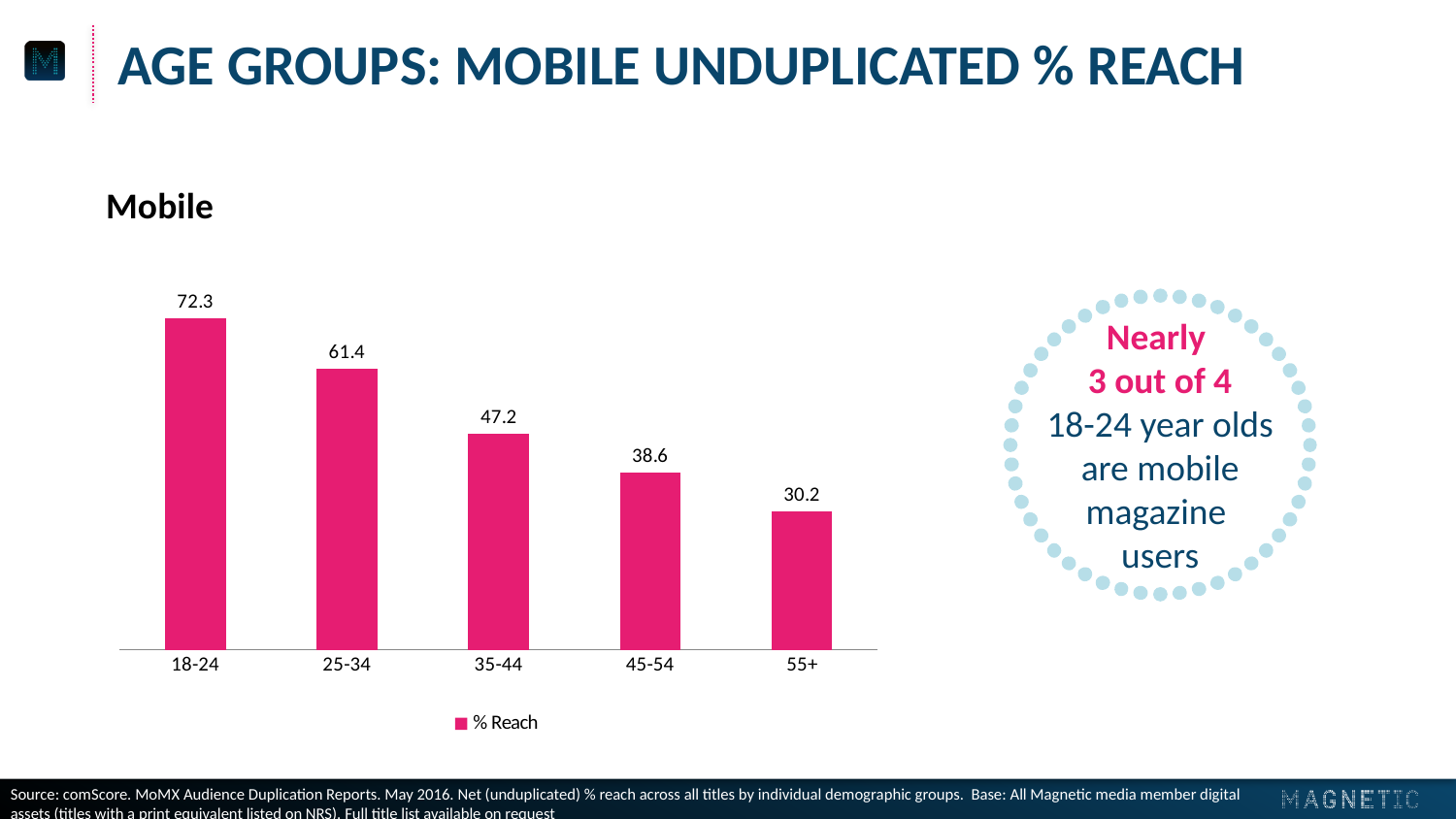
How many series does the legend list? 1 Do the % Reach values rise or fall as age group increases along the x axis? Fall Which age group has the highest % Reach? 18-24 What is the % Reach value for the 18-24 age group? 72.3 What is the % Reach value for the 55+ age group? 30.2 What is the % Reach value for the 35-44 age group? 47.2 What kind of chart is shown on the slide? Bar chart Which age group has the lowest % Reach? 55+ How many age groups are shown in the chart? 5 Which age group has a higher % Reach, 25-34 or 45-54? 25-34 What is the difference in % Reach between the 45-54 and 55+ age groups? 8.4 What is the difference in % Reach between the 18-24 and 25-34 age groups? 10.9